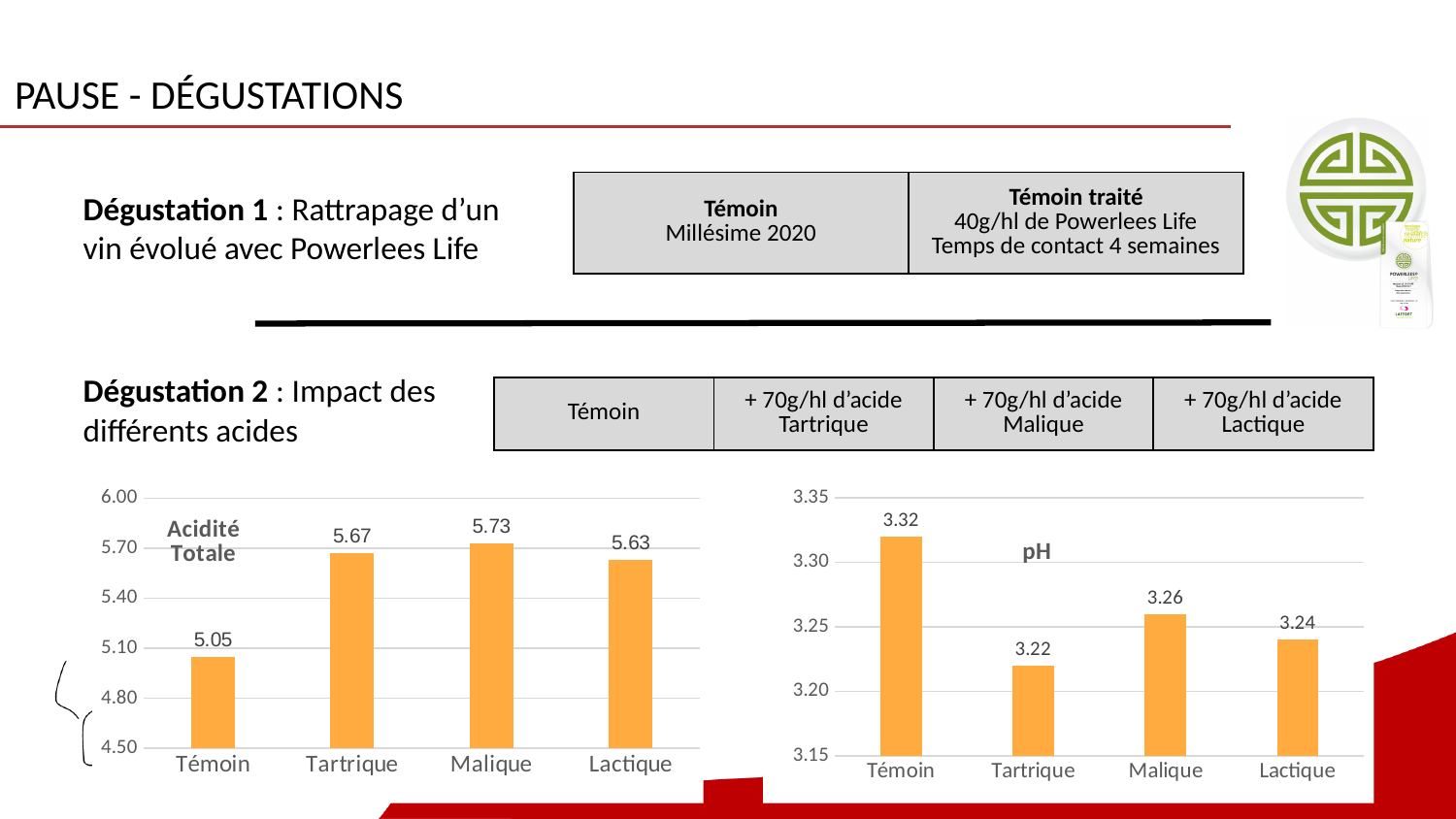
In the Acidité Totale chart, which category has the lowest value? Témoin In the pH chart, which category has the lowest value? Tartrique In the Acidité Totale chart, what is the difference between the Tartrique and Témoin values? 0.62 In the Acidité Totale chart, what is the value for Malique? 5.73 In the pH chart, what is the value for Lactique? 3.24 What type of chart is the pH chart? Bar chart In the Acidité Totale chart, how many categories are shown on the x axis? 4 In the pH chart, what is the difference between the Témoin and Tartrique values? 0.10 In the pH chart, which category has the highest value? Témoin In the pH chart, what is the value for Témoin? 3.32 In the pH chart, is the value for Malique greater or less than 3.25? greater In the Acidité Totale chart, what is the value for Témoin? 5.05